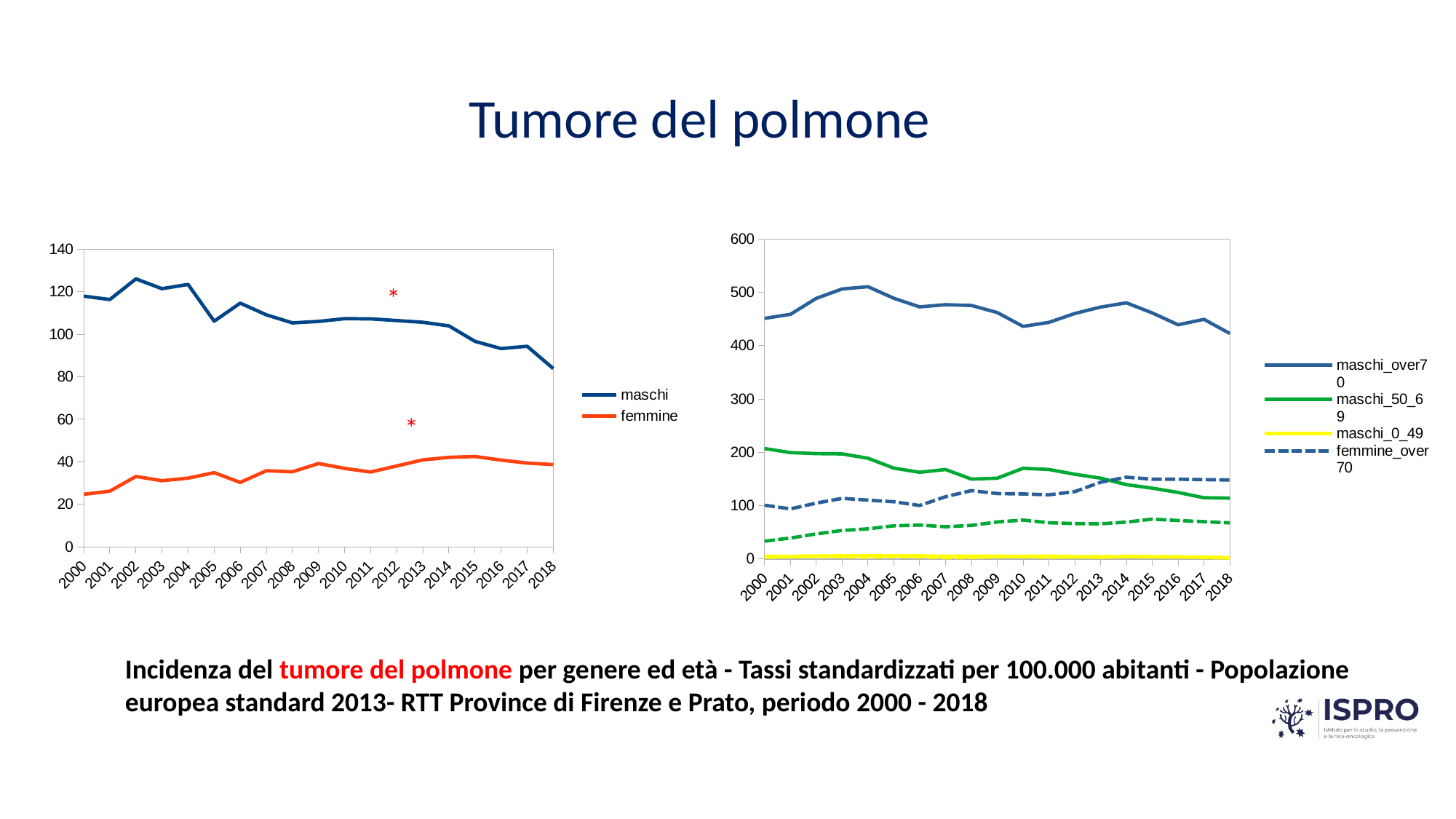
In the left chart, is the value for femmine in 2000 greater or less than 40? less How many series does the legend of the right chart list? 4 How many years are shown on the x axis of the left chart? 19 In the left chart, does the femmine series rise or fall overall from 2000 to 2018? rise In the left chart, in which year is the maschi series lowest? 2018 In the right chart, which series has the highest values throughout the period? maschi_over70 In the left chart, is the value for maschi in 2000 greater or less than 100? greater What kind of chart is the left chart (maschi / femmine)? line chart In the right chart, is the value for maschi_over70 in 2004 greater or less than 500? greater In the left chart, does the maschi series rise or fall overall from 2000 to 2018? fall In the right chart, which is larger in 2018: maschi_50_69 or femmine_over70? femmine_over70